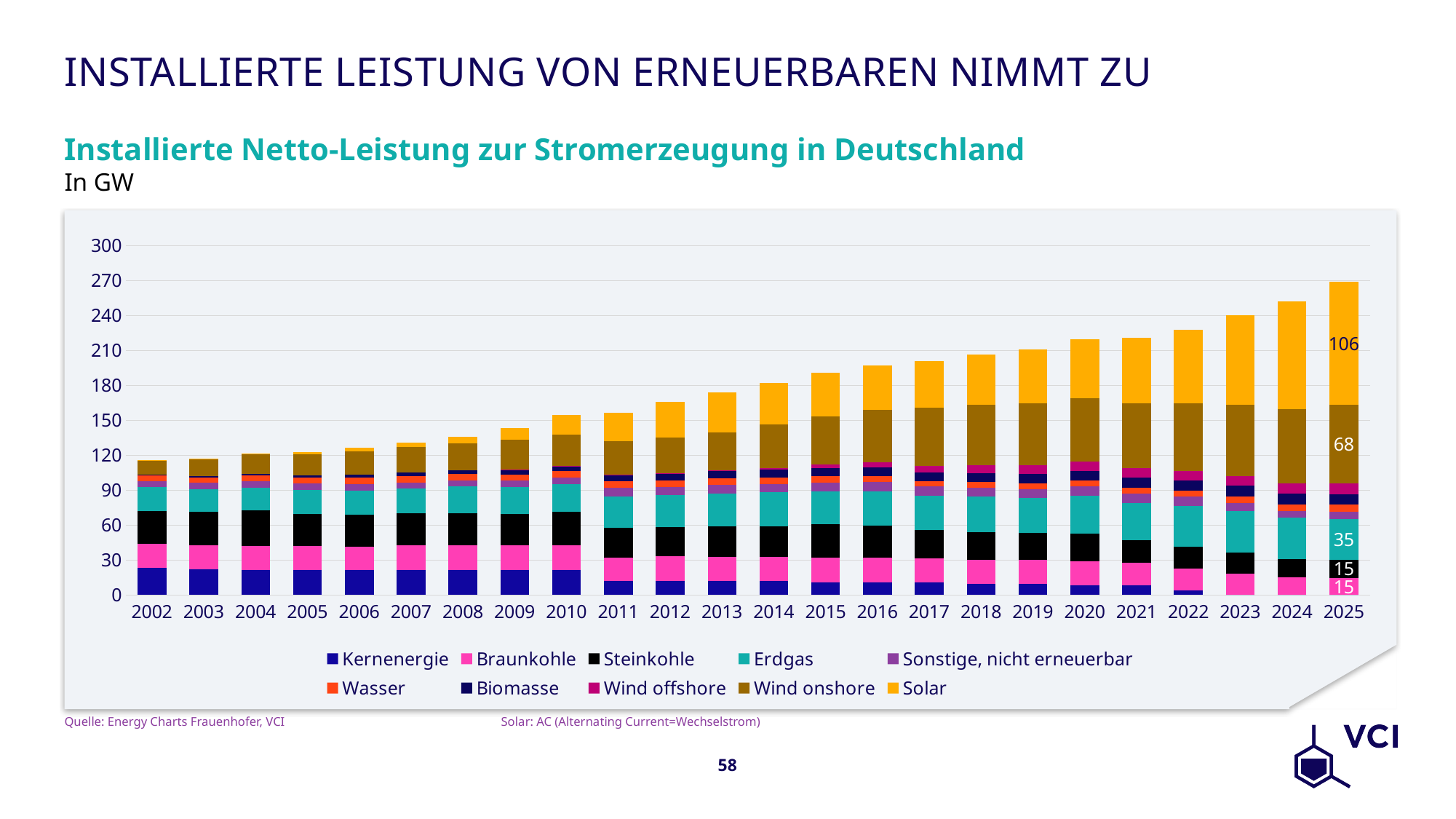
Does the total installed capacity rise or fall from 2002 to 2025? Rise What is the value for Erdgas in 2025? 35 Is the total installed capacity for 2002 greater or less than 150? less How many series does the legend list? 10 What is the value for Wind onshore in 2025? 68 In 2025, which is larger: Solar or Wind onshore? Solar What is the value for Steinkohle in 2025? 15 What is the value for Solar in 2025? 106 Which year has the highest total installed capacity? 2025 What is the difference between Solar and Wind onshore in 2025? 38 How many years are shown on the x axis? 24 What kind of chart is shown on the slide? Stacked bar chart